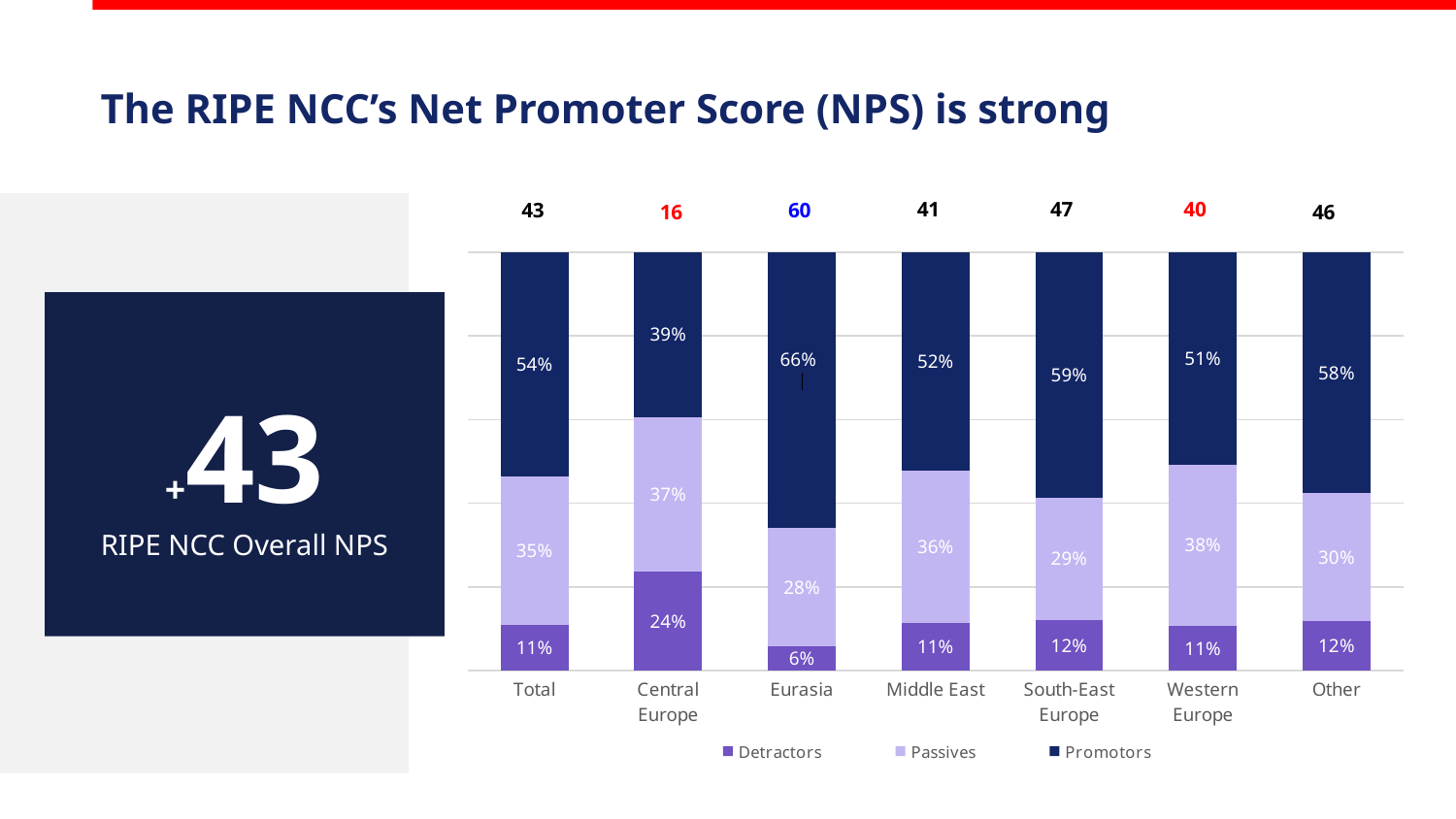
What is the Promotors value for Eurasia? 66% What is the Passives value for Western Europe? 38% How many categories are shown along the x axis of the chart? 7 Which category has the highest Promotors value? Eurasia Which category has the lowest Detractors value? Eurasia What NPS score is printed above the Central Europe bar? 16 What is the difference between the Promotors values for Eurasia and Central Europe? 27% What is the Detractors value for Central Europe? 24% Which is larger, the Passives value for Central Europe or the Passives value for South-East Europe? Central Europe What kind of chart is shown on the slide? Stacked bar chart How many series does the chart legend list? 3 What is the total of the stacked bar for Middle East? 99%